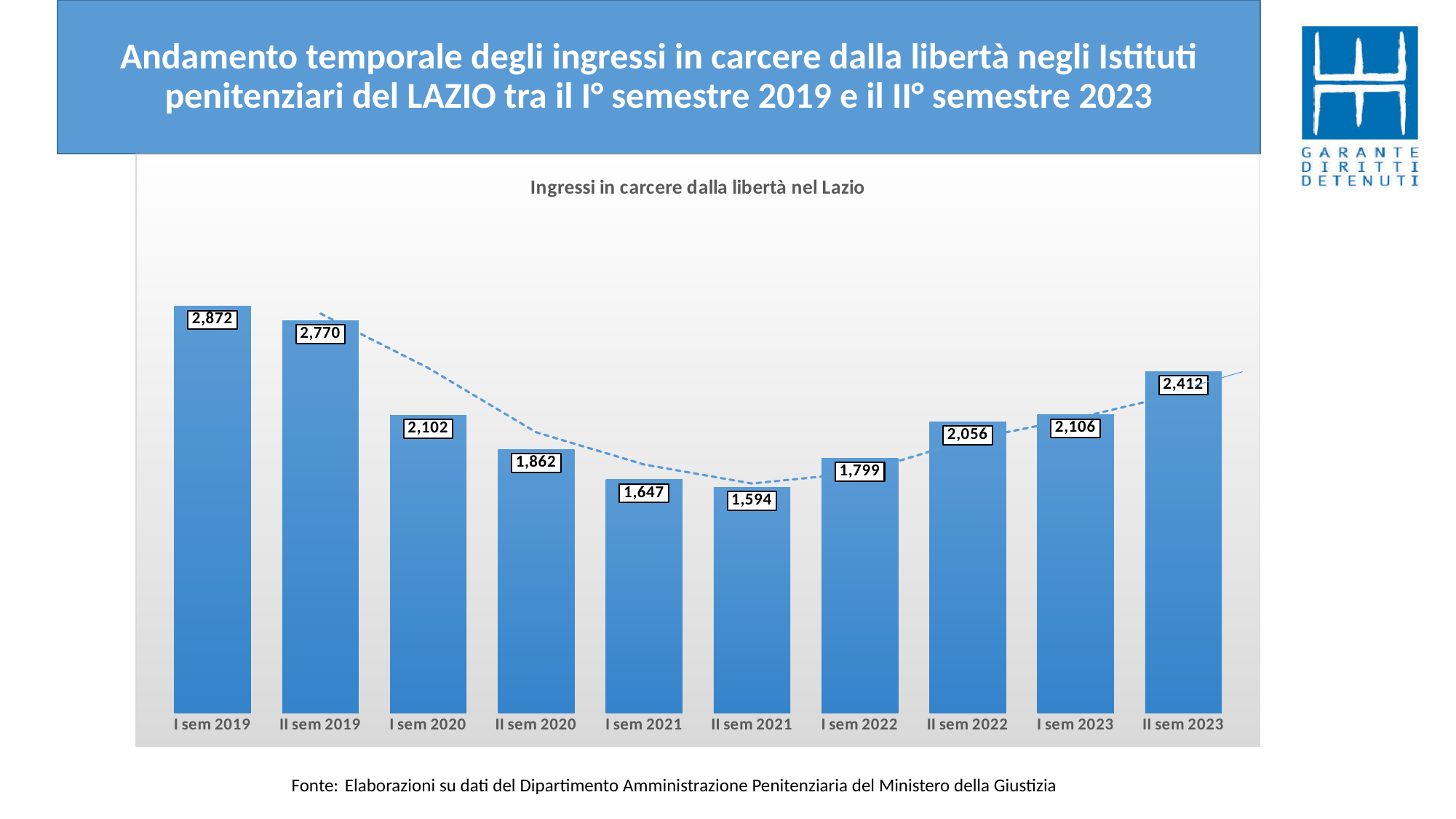
What is the value for I sem 2019? 2,872 What is the difference between the values for II sem 2023 and I sem 2023? 306 Do the values rise or fall from I sem 2019 to II sem 2021? fall What kind of chart is this? bar chart What is the difference between the values for I sem 2019 and II sem 2019? 102 Which is larger, the value for I sem 2020 or the value for I sem 2023? I sem 2023 Which semester has the lowest value? II sem 2021 What is the value for II sem 2023? 2,412 Which semester has the highest value? I sem 2019 How many semesters are shown on the x axis? 10 What is the title of the chart? Ingressi in carcere dalla libertà nel Lazio What is the value for II sem 2021? 1,594